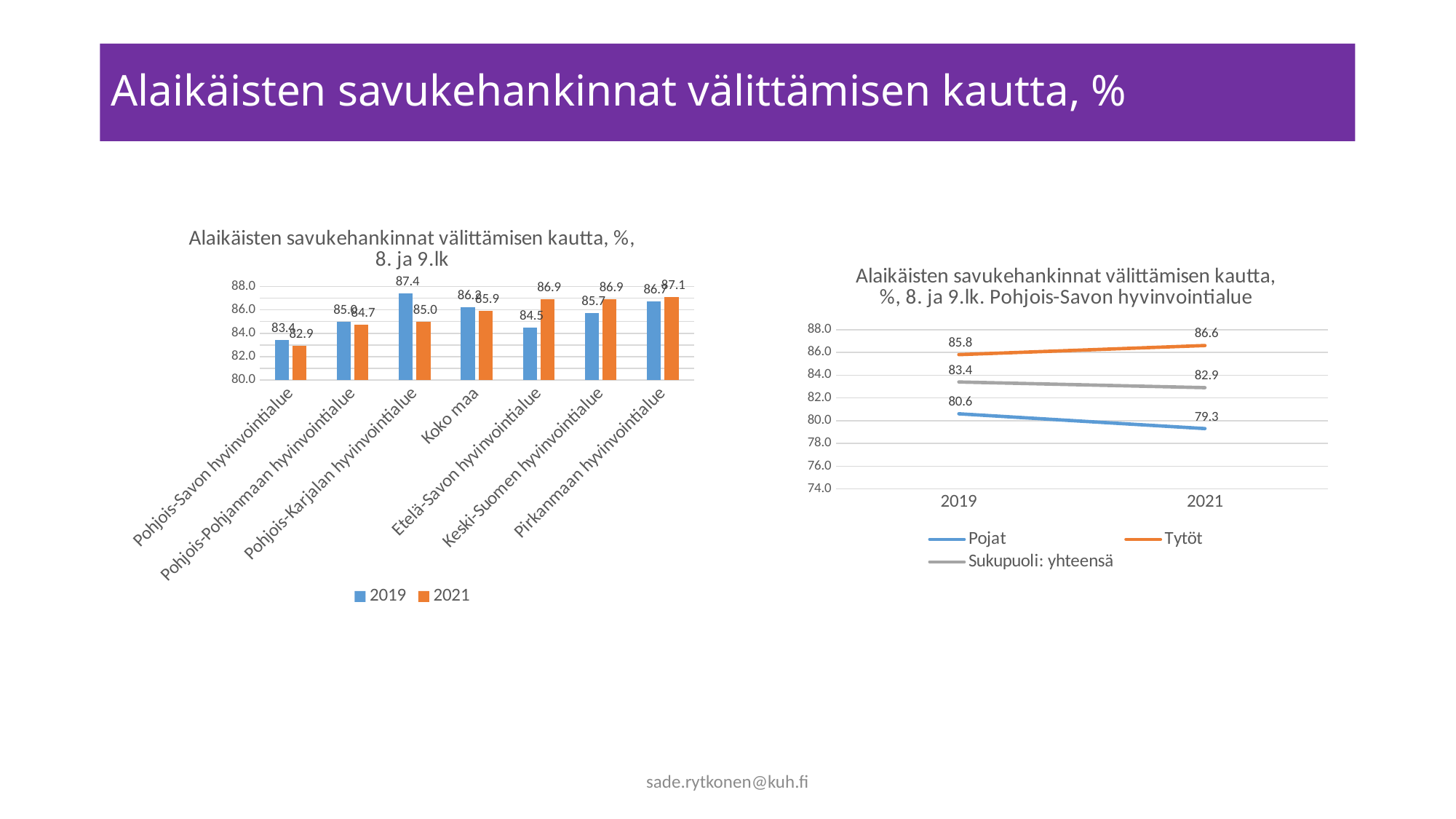
In the right chart (Pohjois-Savon hyvinvointialue), how many series does the legend list? 3 In the left chart (8. ja 9.lk), which category has the highest 2019 value? Pohjois-Karjalan hyvinvointialue In the left chart (8. ja 9.lk), what is the 2021 value for Etelä-Savon hyvinvointialue? 86.9 In the right chart (Pohjois-Savon hyvinvointialue), what is the value for Tytöt in 2021? 86.6 What kind of chart is the left chart (8. ja 9.lk)? bar chart In the right chart (Pohjois-Savon hyvinvointialue), what is the difference between the Tytöt and Pojat values in 2019? 5.2 In the left chart (8. ja 9.lk), how many categories are shown on the x axis? 7 In the left chart (8. ja 9.lk), what is the difference between the 2019 and 2021 values for Pohjois-Karjalan hyvinvointialue? 2.4 In the left chart (8. ja 9.lk), which category has the lowest 2021 value? Pohjois-Savon hyvinvointialue In the left chart (8. ja 9.lk), is the 2019 value for Etelä-Savon hyvinvointialue larger or smaller than its 2021 value? smaller In the left chart (8. ja 9.lk), what is the 2019 value for Pohjois-Savon hyvinvointialue? 83.4 In the right chart (Pohjois-Savon hyvinvointialue), does the Pojat line rise or fall from 2019 to 2021? fall